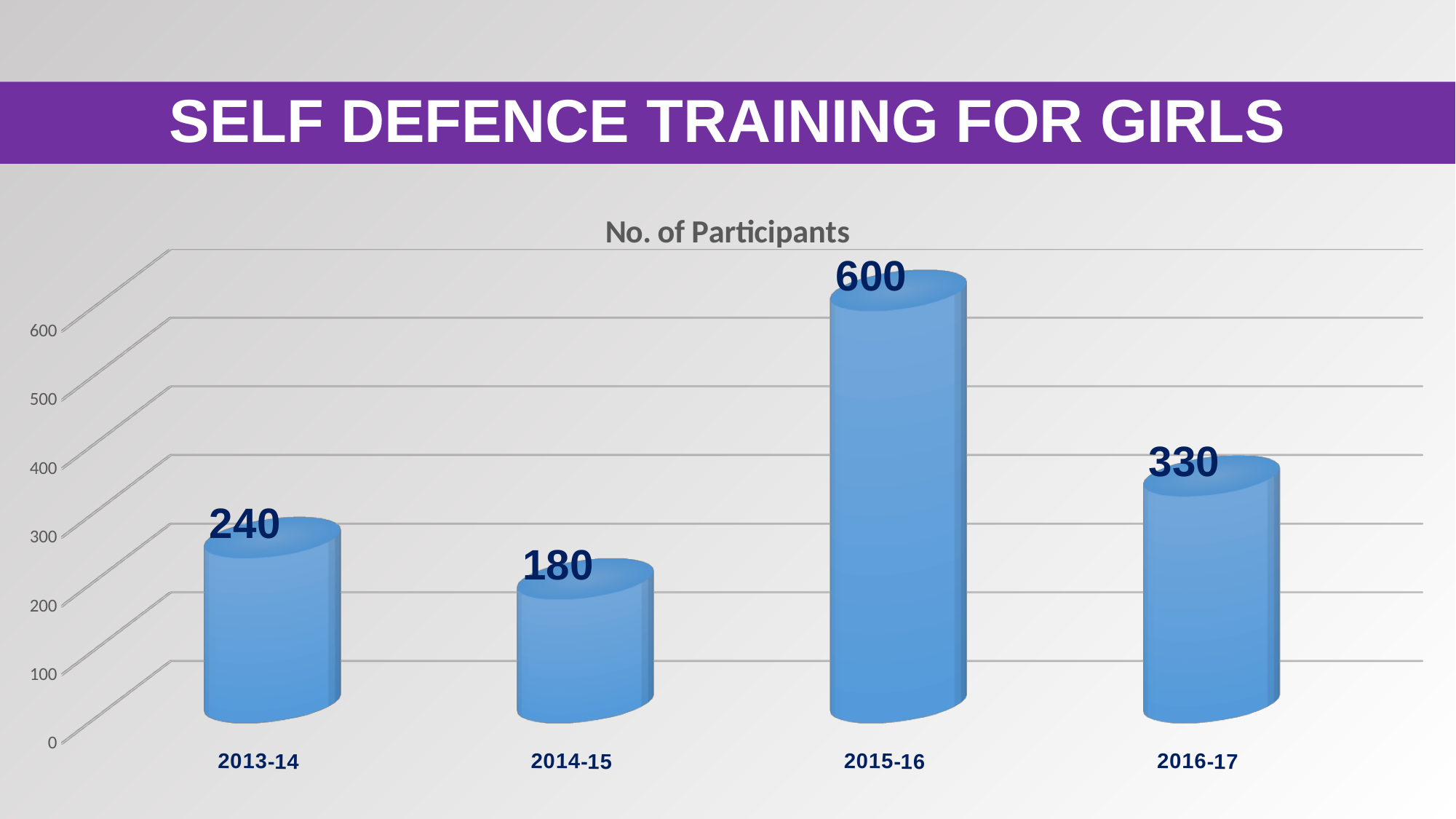
What is the difference in participants between 2015-16 and 2016-17? 270 What kind of chart is shown on the slide? Bar chart What is the title of the chart? No. of Participants How many years are shown on the chart? 4 What is the number of participants for 2014-15? 180 What is the number of participants for 2016-17? 330 Which year had more participants, 2013-14 or 2016-17? 2016-17 What is the difference in participants between 2013-14 and 2014-15? 60 Which year has the highest number of participants? 2015-16 Which year has the lowest number of participants? 2014-15 What is the number of participants for 2013-14? 240 What is the number of participants for 2015-16? 600